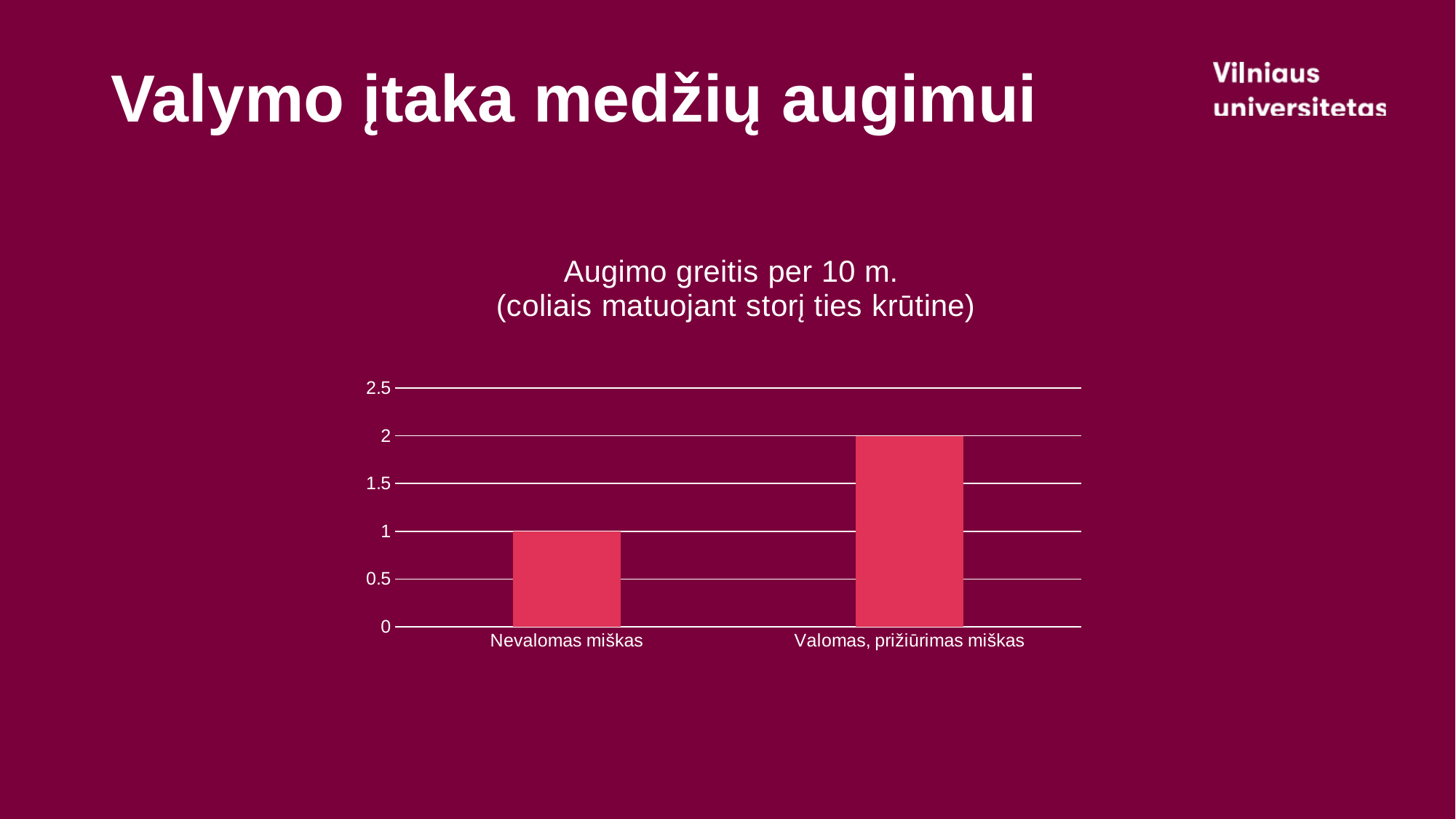
What is the value for Valomas, prižiūrimas miškas? 2 What is the value for Nevalomas miškas? 1 What type of chart is shown on the slide? bar chart How many categories are plotted in the chart? 2 What is the difference between the values for Valomas, prižiūrimas miškas and Nevalomas miškas? 1 Which category has the lowest value? Nevalomas miškas Is the value for Nevalomas miškas greater or less than 1.5? less Is the value for Valomas, prižiūrimas miškas greater or less than 1.5? greater Which is larger: the value for Nevalomas miškas or the value for Valomas, prižiūrimas miškas? Valomas, prižiūrimas miškas What is the highest value shown on the vertical axis? 2.5 Which category has the highest value? Valomas, prižiūrimas miškas What is the title of the chart? Augimo greitis per 10 m. (coliais matuojant storį ties krūtine)